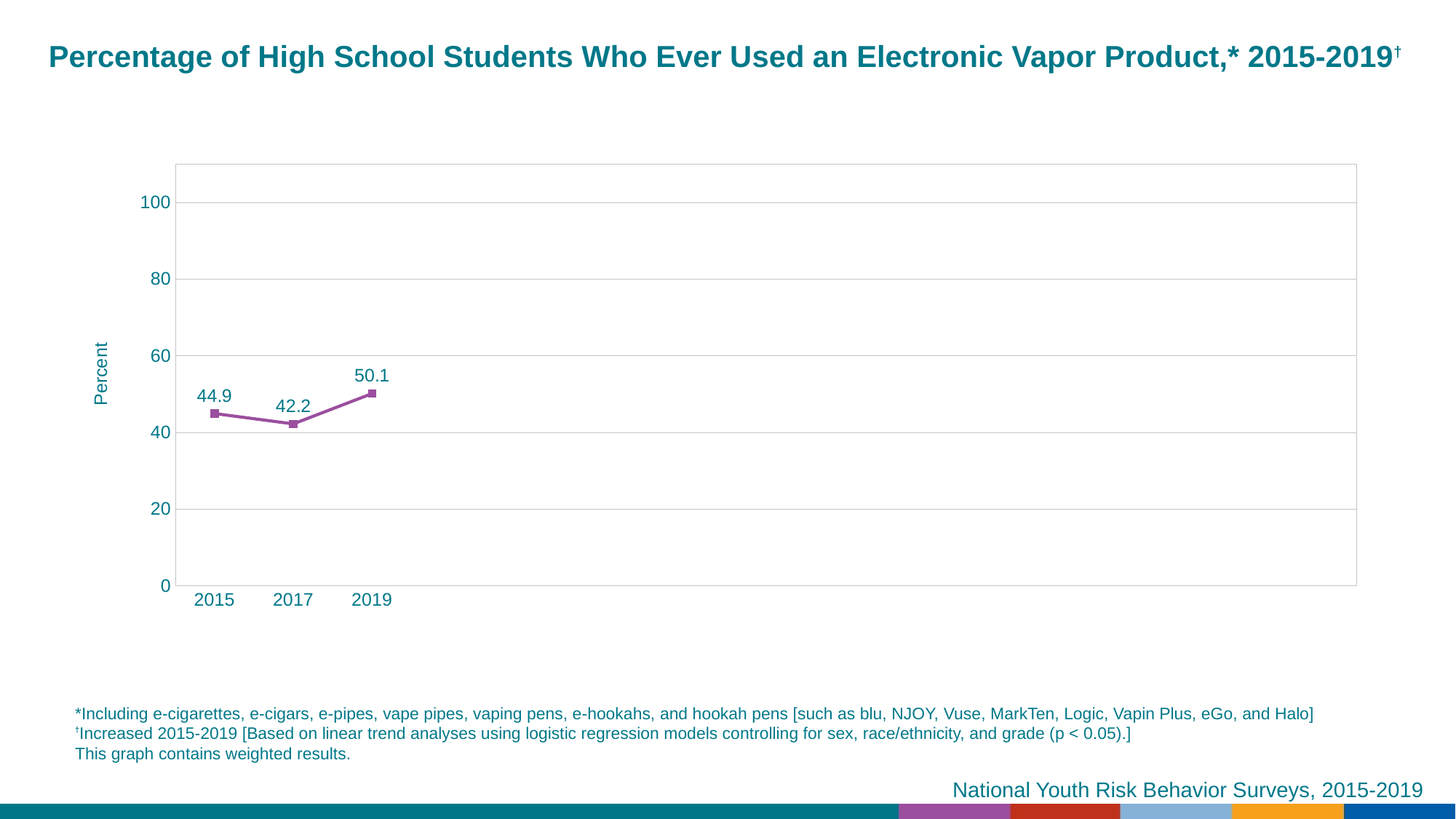
Which year has the lowest percentage of students who ever used an electronic vapor product? 2017 What is the difference between the 2015 and 2017 percentages? 2.7 How many years are plotted on the chart? 3 Which year has a larger value, 2015 or 2017? 2015 What percentage of high school students had ever used an electronic vapor product in 2019? 50.1 Which year has the highest percentage of students who ever used an electronic vapor product? 2019 What is the label on the y axis of the chart? Percent What percentage of high school students had ever used an electronic vapor product in 2015? 44.9 What kind of chart is shown on the slide? Line chart Is the value for 2019 greater or less than 40? greater What is the difference between the 2019 and 2015 percentages? 5.2 What percentage of high school students had ever used an electronic vapor product in 2017? 42.2